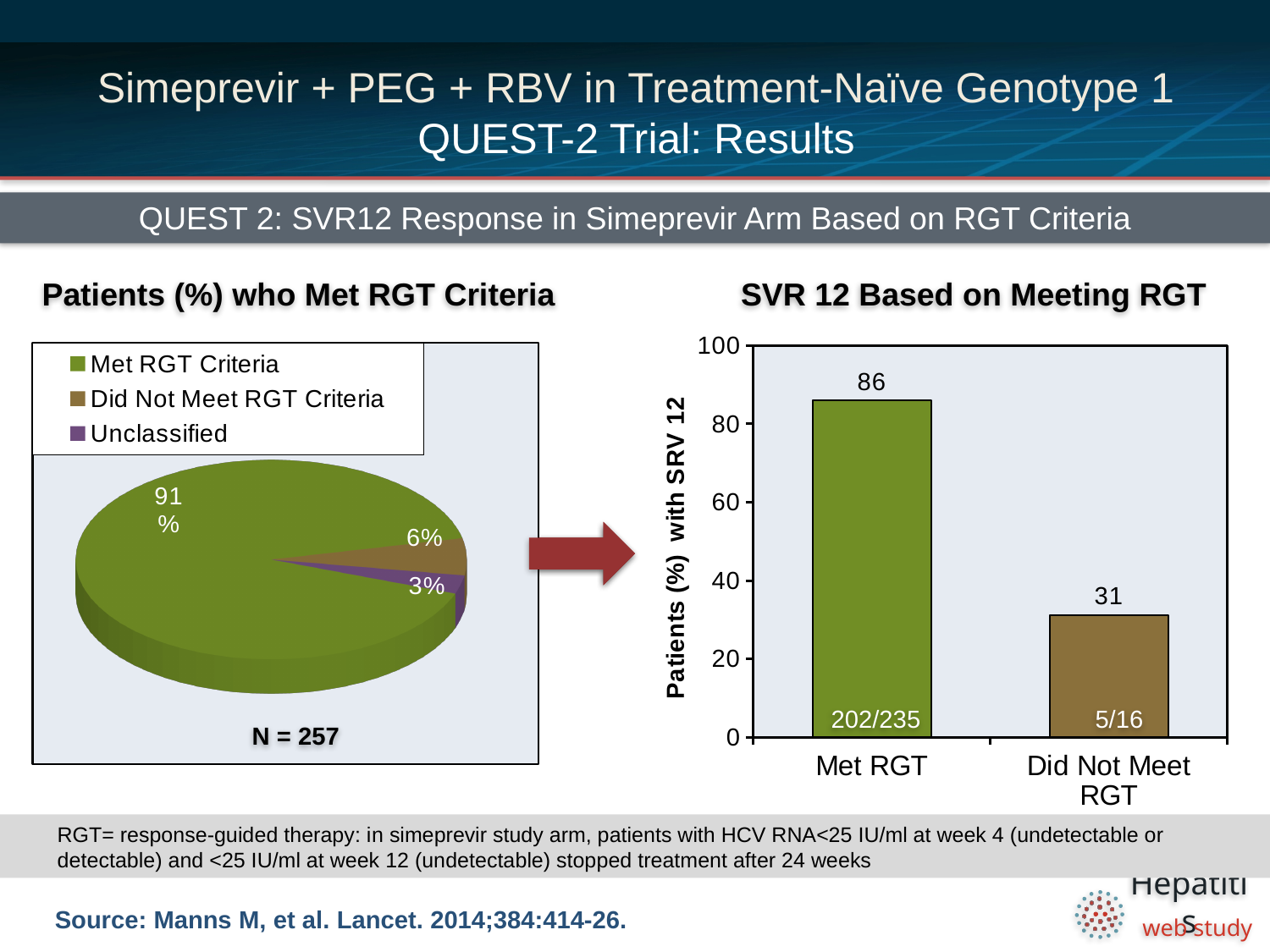
What kind of chart is 'SVR 12 Based on Meeting RGT'? Bar chart In the 'Patients (%) who Met RGT Criteria' pie chart, how many categories does the legend list? 3 In the 'Patients (%) who Met RGT Criteria' chart, what is the total number of patients (N) shown? N = 257 In the 'SVR 12 Based on Meeting RGT' bar chart, what fraction is printed inside the Did Not Meet RGT bar? 5/16 In the 'Patients (%) who Met RGT Criteria' pie chart, which category has the smallest slice? Unclassified In the 'SVR 12 Based on Meeting RGT' bar chart, what is the difference between the Met RGT and Did Not Meet RGT values? 55 In the 'Patients (%) who Met RGT Criteria' pie chart, what percentage of patients did not meet RGT criteria? 6% In the 'SVR 12 Based on Meeting RGT' bar chart, what is the value for Did Not Meet RGT? 31 In the 'Patients (%) who Met RGT Criteria' pie chart, what percentage of patients were unclassified? 3% In the 'Patients (%) who Met RGT Criteria' pie chart, what percentage of patients met RGT criteria? 91% In the 'Patients (%) who Met RGT Criteria' pie chart, which category has the largest slice? Met RGT Criteria In the 'SVR 12 Based on Meeting RGT' bar chart, what is the value for Met RGT? 86